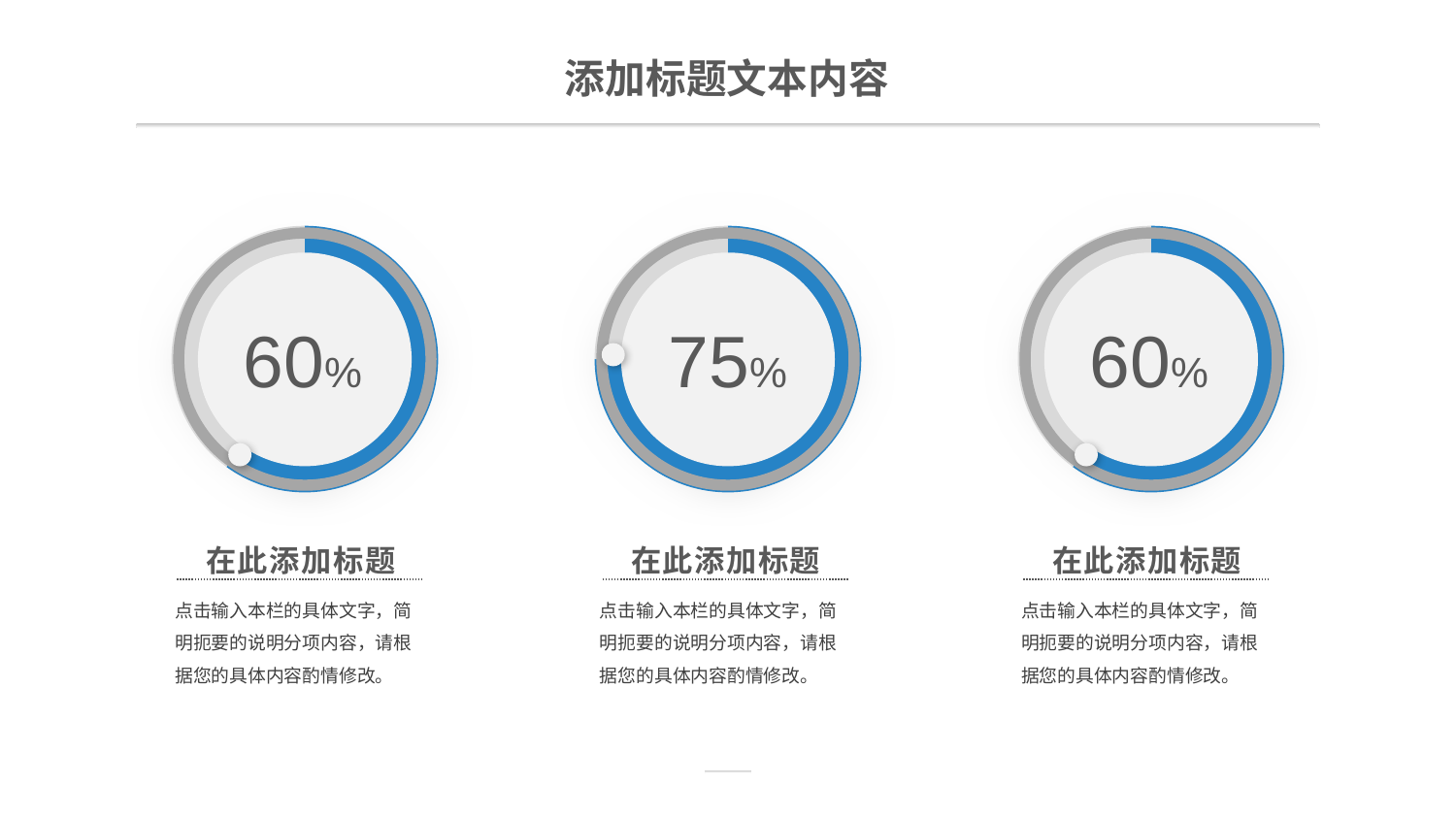
How many circular progress charts are on the slide? 3 What kind of chart is used on this slide? Circular progress (ring/donut) charts What value is shown in the left circular chart? 60% What is the difference between the percentage in the middle chart and the percentage in the left chart? 15% Do the left and right circular charts show the same percentage? Yes, both show 60% Is the value in the middle chart greater or less than 70%? greater What colour is used for the filled portion of each ring? Blue What value is shown in the right circular chart? 60% Is the value in the middle chart larger or smaller than the value in the right chart? Larger What is the title of the slide? 添加标题文本内容 What value is shown in the middle circular chart? 75% Which of the three circular charts shows the highest percentage? The middle chart